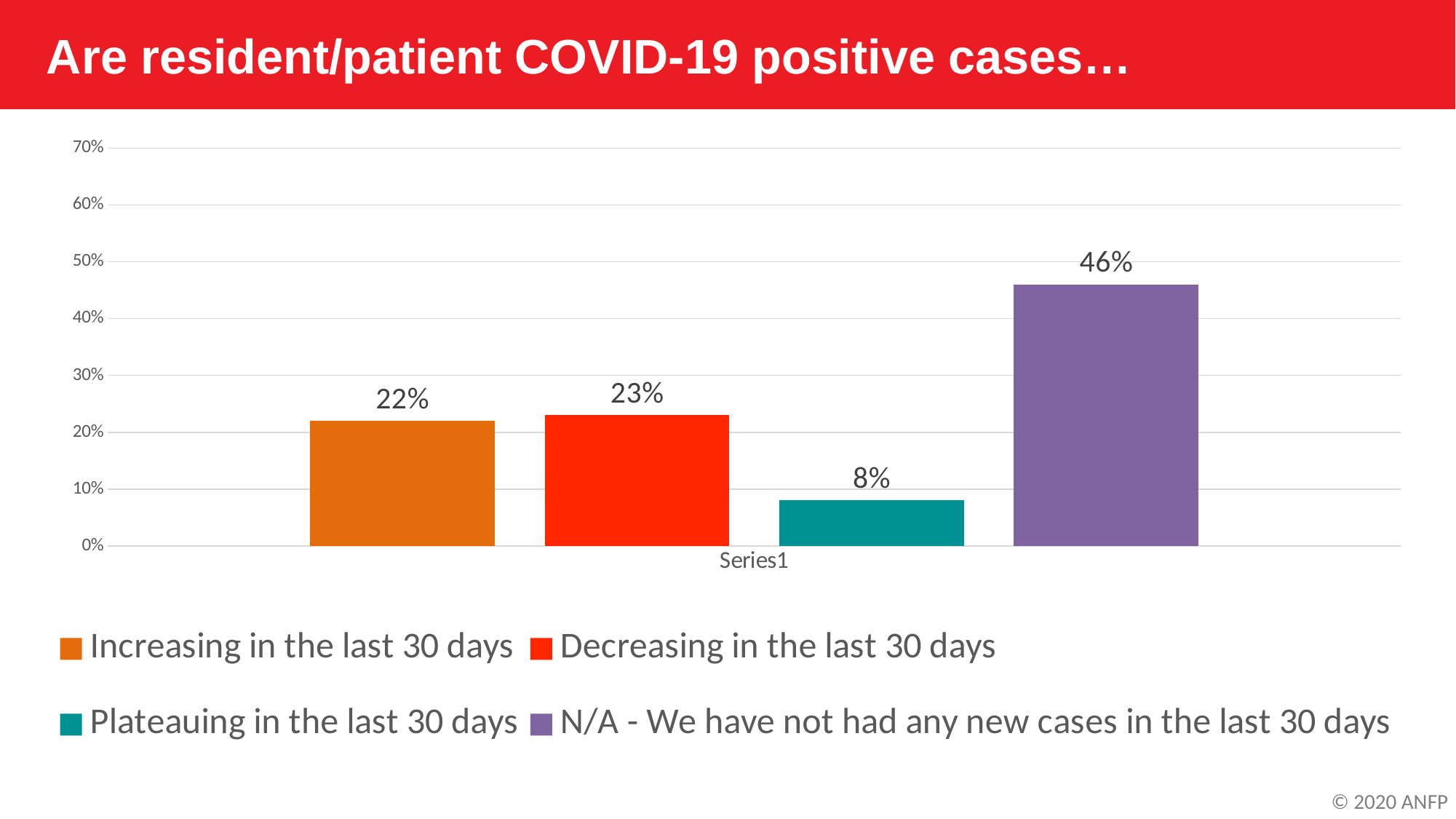
Is the value for N/A - We have not had any new cases in the last 30 days greater or less than 40%? greater Which is larger: the percentage for Increasing in the last 30 days or for Plateauing in the last 30 days? Increasing in the last 30 days Which response has the lowest percentage? Plateauing in the last 30 days How many response categories are shown in the legend? 4 What percentage of respondents said N/A - We have not had any new cases in the last 30 days? 46% What percentage of respondents said COVID-19 positive cases are plateauing in the last 30 days? 8% What is the difference in percentage points between Decreasing in the last 30 days and Plateauing in the last 30 days? 15 Which response has the highest percentage? N/A - We have not had any new cases in the last 30 days What type of chart is shown on the slide? Bar chart What is the difference in percentage points between the N/A response and the Increasing in the last 30 days response? 24 What percentage of respondents said COVID-19 positive cases are decreasing in the last 30 days? 23% What percentage of respondents said COVID-19 positive cases are increasing in the last 30 days? 22%